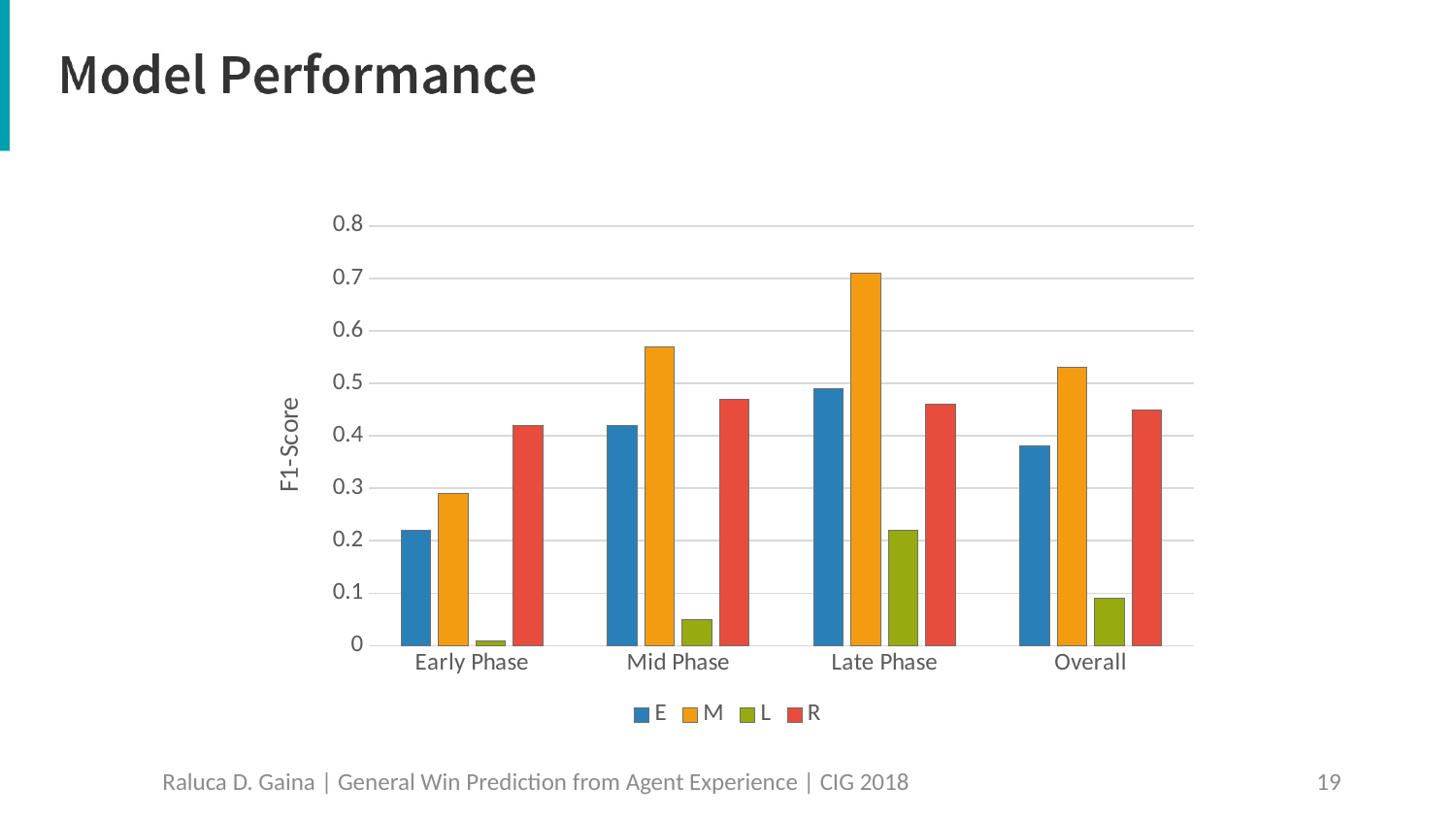
Is the value for L in Late Phase greater or less than 0.3? less How many series does the legend list? 4 In the Mid Phase category, which is larger, the value for M or the value for R? M In which category does series M reach its highest value? Late Phase What is the label on the y axis? F1-Score Is the value for M in Late Phase greater or less than 0.6? greater Is the value for E in Overall greater or less than 0.5? less How many categories are shown on the x axis? 4 Which series has the lowest bar in the Early Phase category? L What kind of chart is shown on the slide? bar chart Do the values for series M rise or fall from Early Phase to Late Phase? rise Which series has the highest bar in the Late Phase category? M